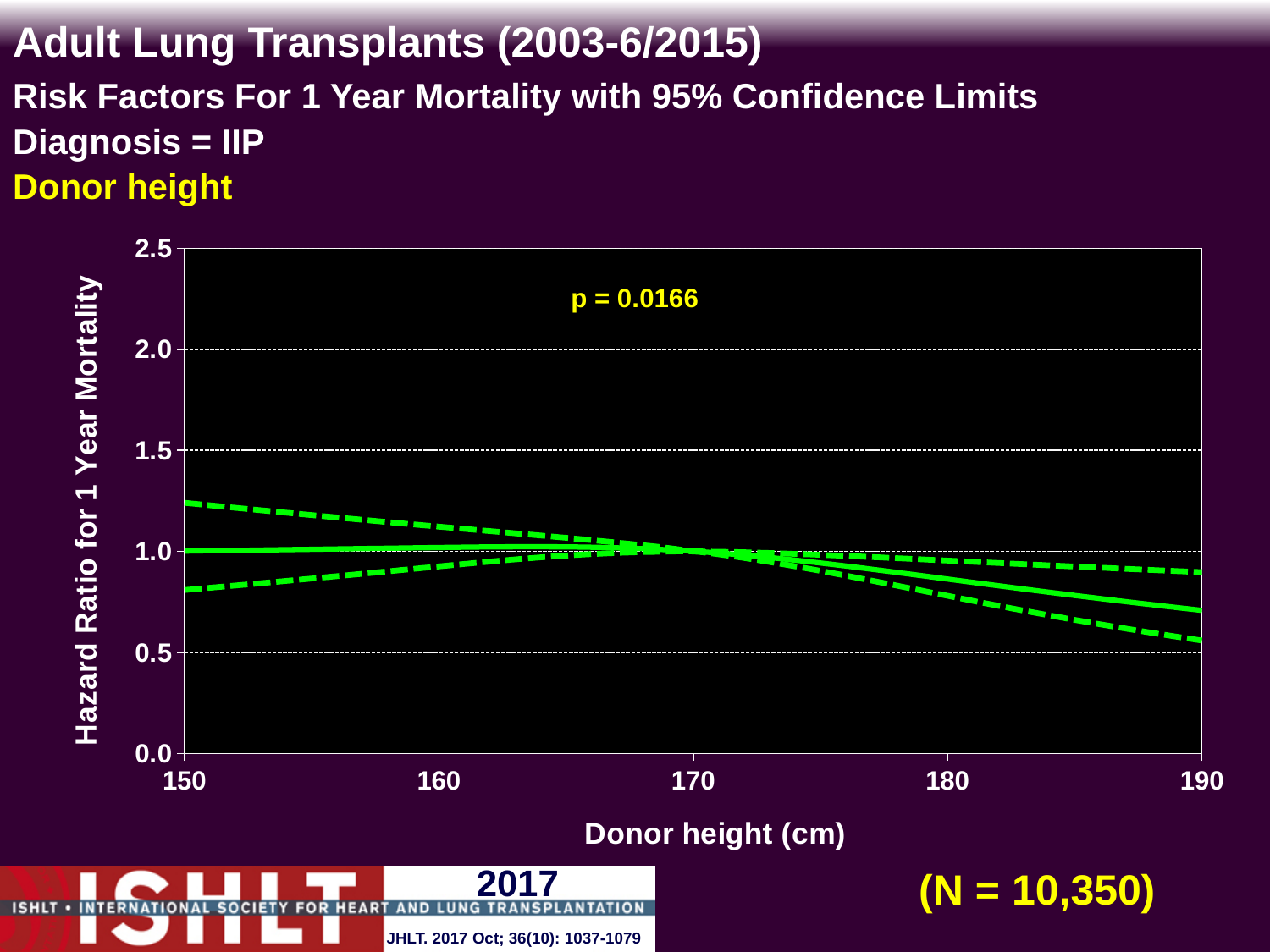
How many lines are plotted on the chart? 3 Is the upper dashed confidence limit at a donor height of 190 cm greater or less than 1.0? less What is the p-value printed on the chart? p = 0.0166 What is the sample size (N) shown on the slide? N = 10,350 Is the solid hazard ratio line at a donor height of 160 cm greater or less than 1.5? less Is the upper dashed confidence limit at a donor height of 150 cm greater or less than 1.0? greater Does the solid hazard ratio line rise or fall as donor height increases from 150 cm to 190 cm? fall Is the solid hazard ratio line higher at a donor height of 150 cm or at 190 cm? 150 cm What kind of chart is shown on the slide? line chart What is the maximum value shown on the y axis of the chart? 2.5